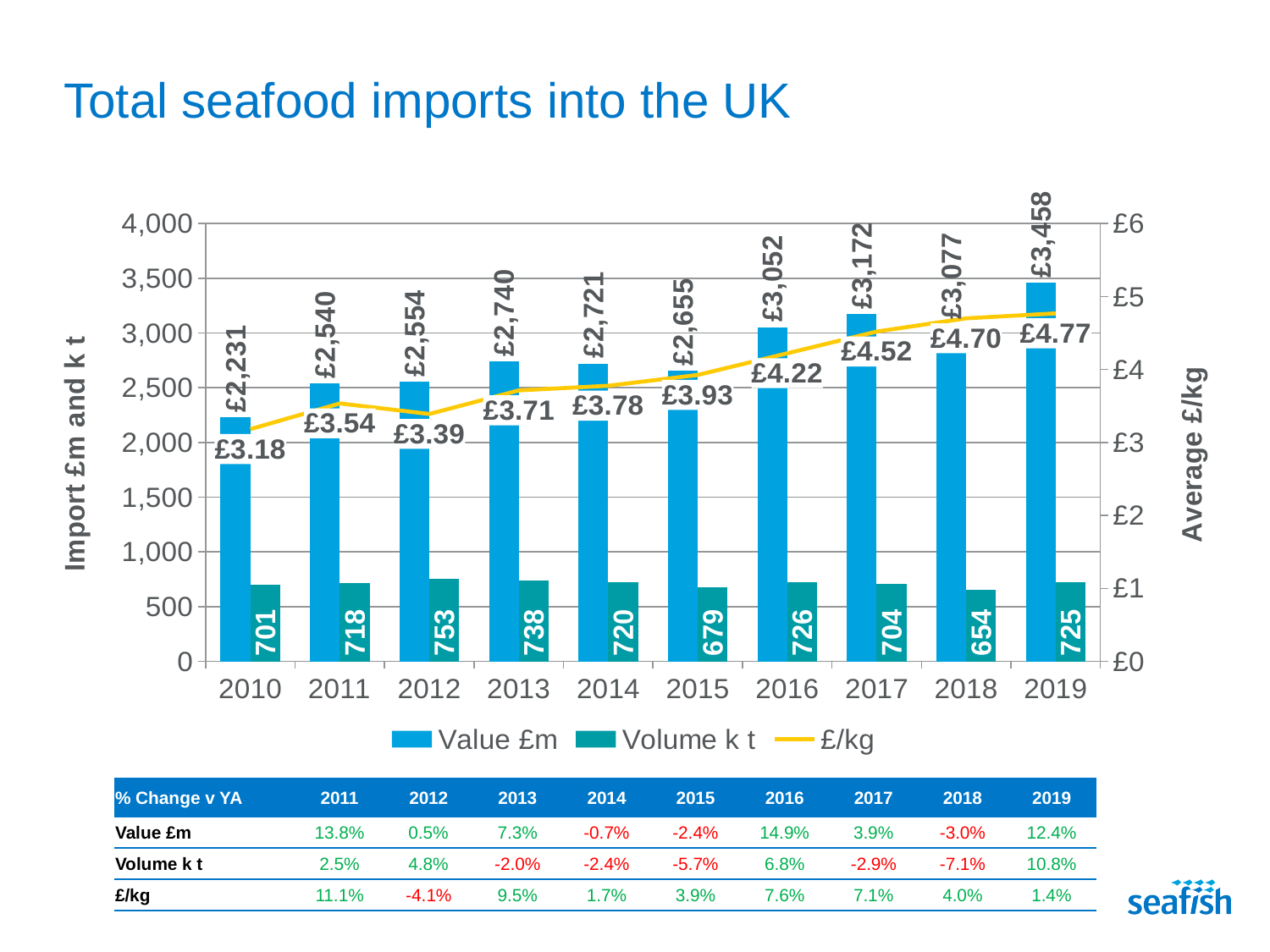
What kind of chart is used to show Value £m and Volume k t? Bar chart Which year has the lowest Volume k t? 2018 Does the £/kg line generally rise or fall from 2010 to 2019? Rise How many series does the chart legend list? 3 How many years are shown on the x axis of the chart? 10 What is the Value £m of seafood imports in 2019? £3,458 Which year has the highest Value £m? 2019 What is the title of the chart? Total seafood imports into the UK What is the £/kg value shown for 2016? £4.22 Which year has the larger Volume k t, 2015 or 2016? 2016 What is the Volume k t of seafood imports in 2012? 753 What is the difference in Value £m between 2019 and 2018? £381